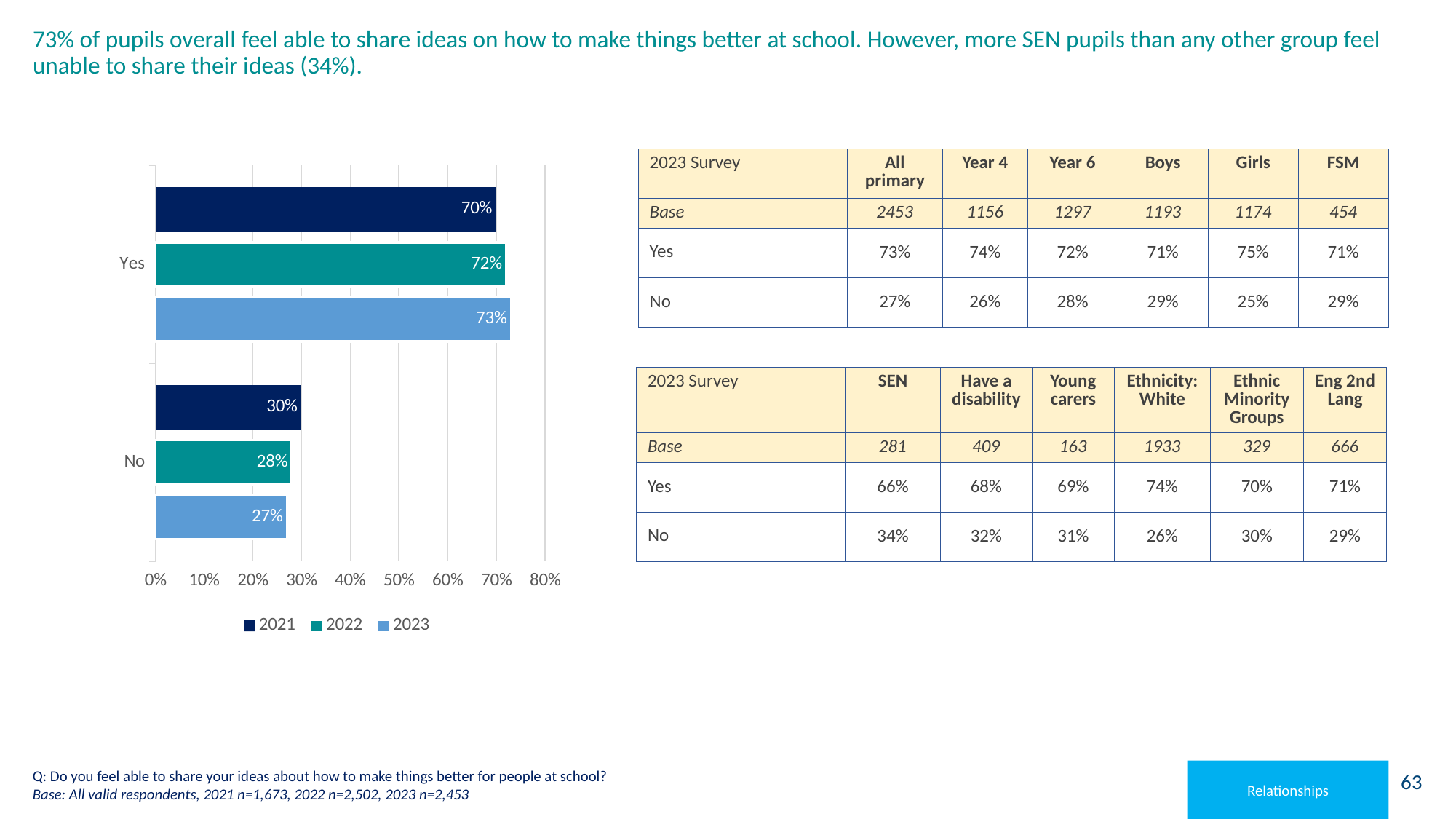
Which series is shown in the darkest blue colour? 2021 What is the value for 'No' in 2023? 27% What kind of chart is shown on the slide? Bar chart How many categories are shown on the chart? 2 What is the value for 'No' in 2021? 30% Which is larger: the 'No' value for 2021 or for 2022? 2021 What is the value for 'Yes' in 2022? 72% How many series does the legend list? 3 What is the difference between the 'Yes' values for 2023 and 2021? 3% Which year has the highest value for 'Yes'? 2023 Which year has the lowest value for 'No'? 2023 What is the value for 'Yes' in 2023? 73%